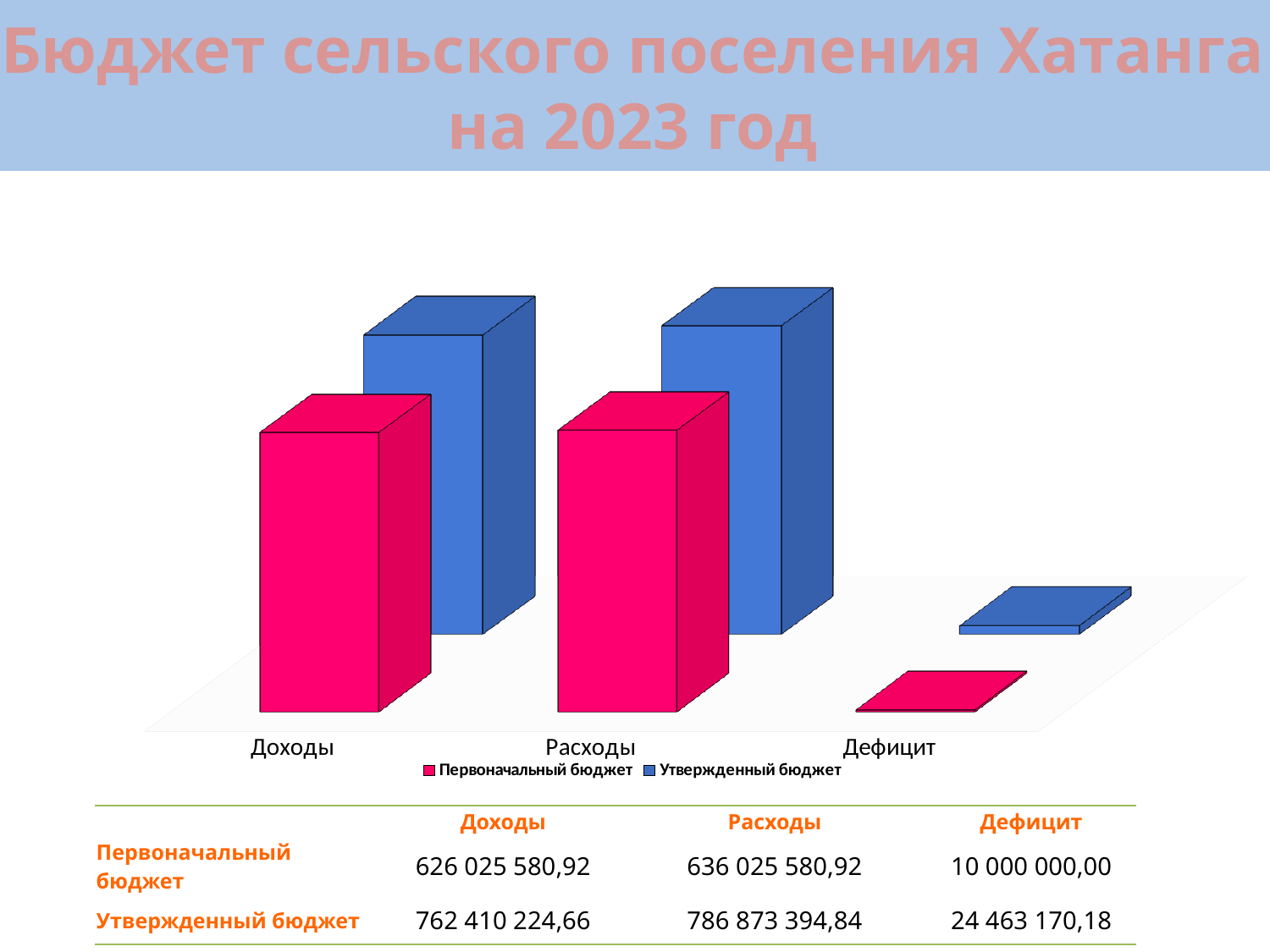
What is the value of Доходы for Первоначальный бюджет? 626 025 580,92 What is the value of Дефицит for Первоначальный бюджет? 10 000 000,00 What is the difference between Утвержденный бюджет and Первоначальный бюджет for Дефицит? 14 463 170,18 Which is larger for Доходы: Первоначальный бюджет or Утвержденный бюджет? Утвержденный бюджет Which category has the highest value for Утвержденный бюджет? Расходы How many categories are shown on the x axis of the chart? 3 What is the value of Дефицит for Утвержденный бюджет? 24 463 170,18 What is the value of Расходы for Утвержденный бюджет? 786 873 394,84 What is the difference between Расходы and Доходы for Первоначальный бюджет? 10 000 000,00 How many series does the chart legend list? 2 What kind of chart is shown on the slide? bar chart Which category has the lowest value for Первоначальный бюджет? Дефицит